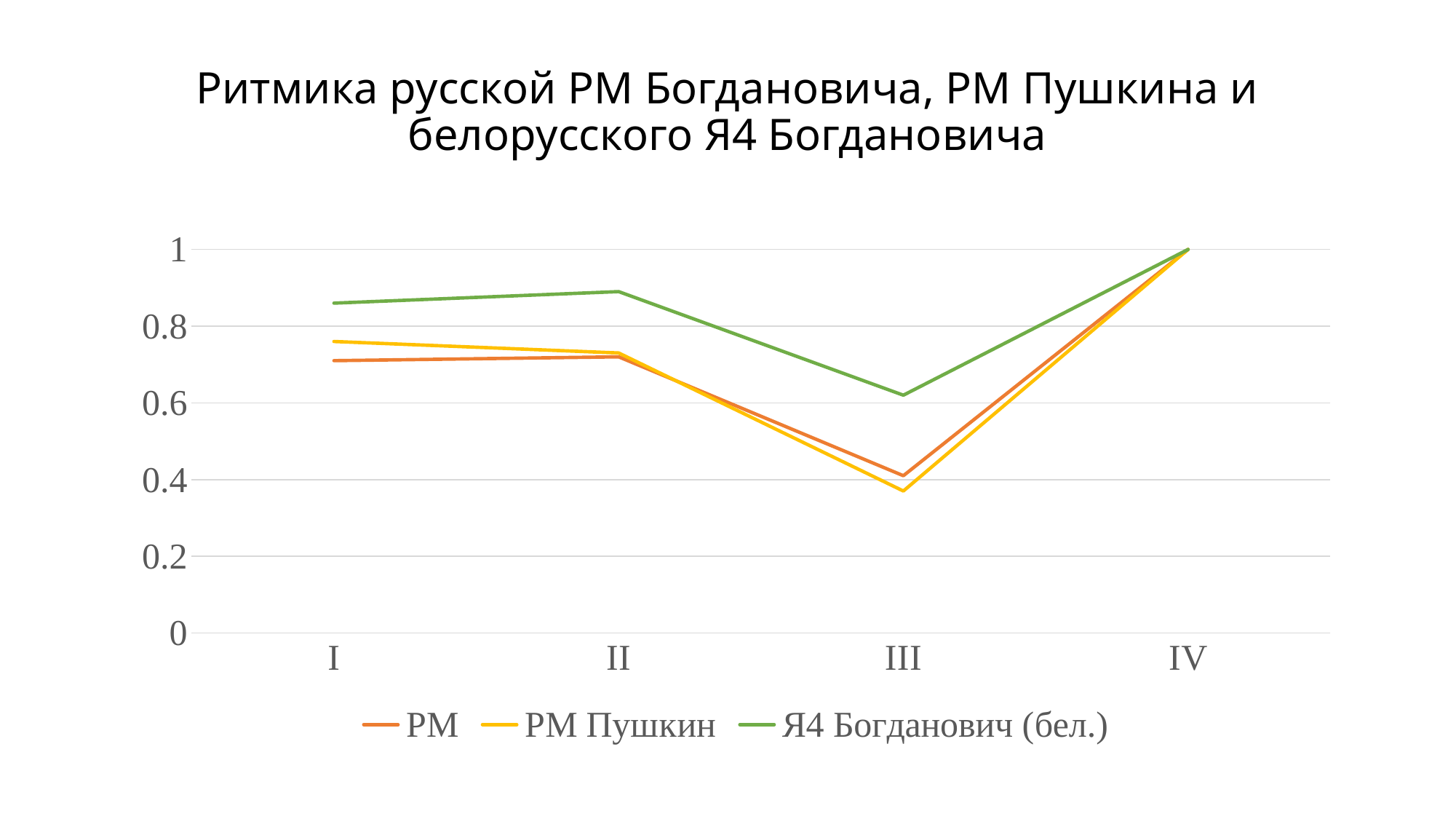
Which series is drawn in green? Я4 Богданович (бел.) Does the РМ series rise or fall from category II to category III? fall At which category is the Я4 Богданович (бел.) series lowest? III Is the value for Я4 Богданович (бел.) at category I greater or less than 0.8? greater What kind of chart is shown on the slide? line chart At category III, which series has the larger value: Я4 Богданович (бел.) or РМ Пушкин? Я4 Богданович (бел.) How many categories are shown on the x axis? 4 Is the value for РМ Пушкин at category III greater or less than 0.4? less What is the value of the Я4 Богданович (бел.) series at category IV? 1 What is the value of the РМ series at category IV? 1 How many series does the legend list? 3 At which category is the РМ Пушкин series highest? IV